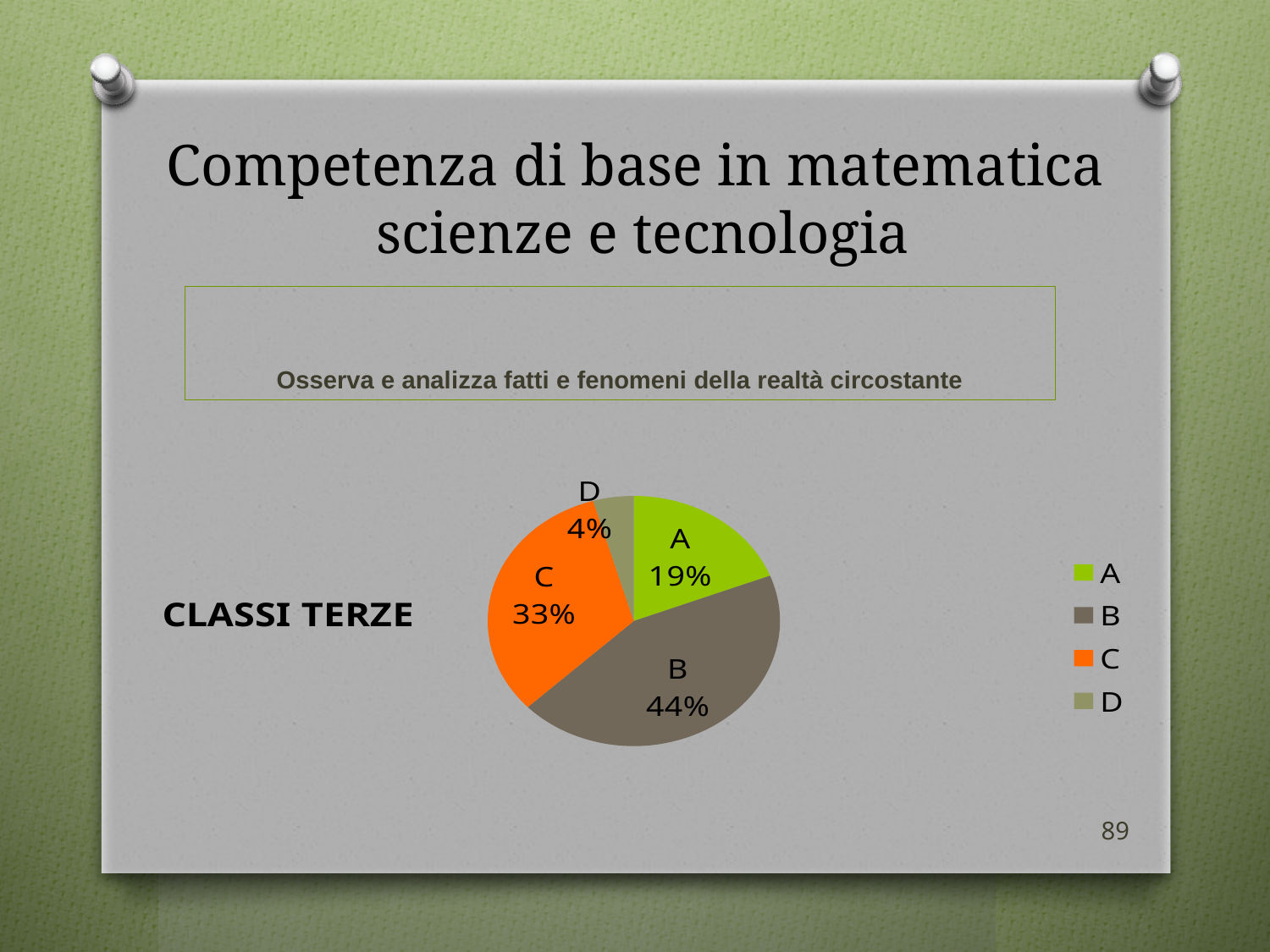
What colour is slice C in the pie chart? orange What percentage does slice A represent? 19% Which slice is the largest? B Which is larger, slice A or slice C? C What kind of chart is shown on the slide? pie chart How many entries does the legend list? 4 What is the difference in percentage points between slice B and slice C? 11 What percentage does slice D represent? 4% Which slice is the smallest? D How many slices does the pie chart have? 4 What percentage does slice C represent? 33% What percentage does slice B represent? 44%